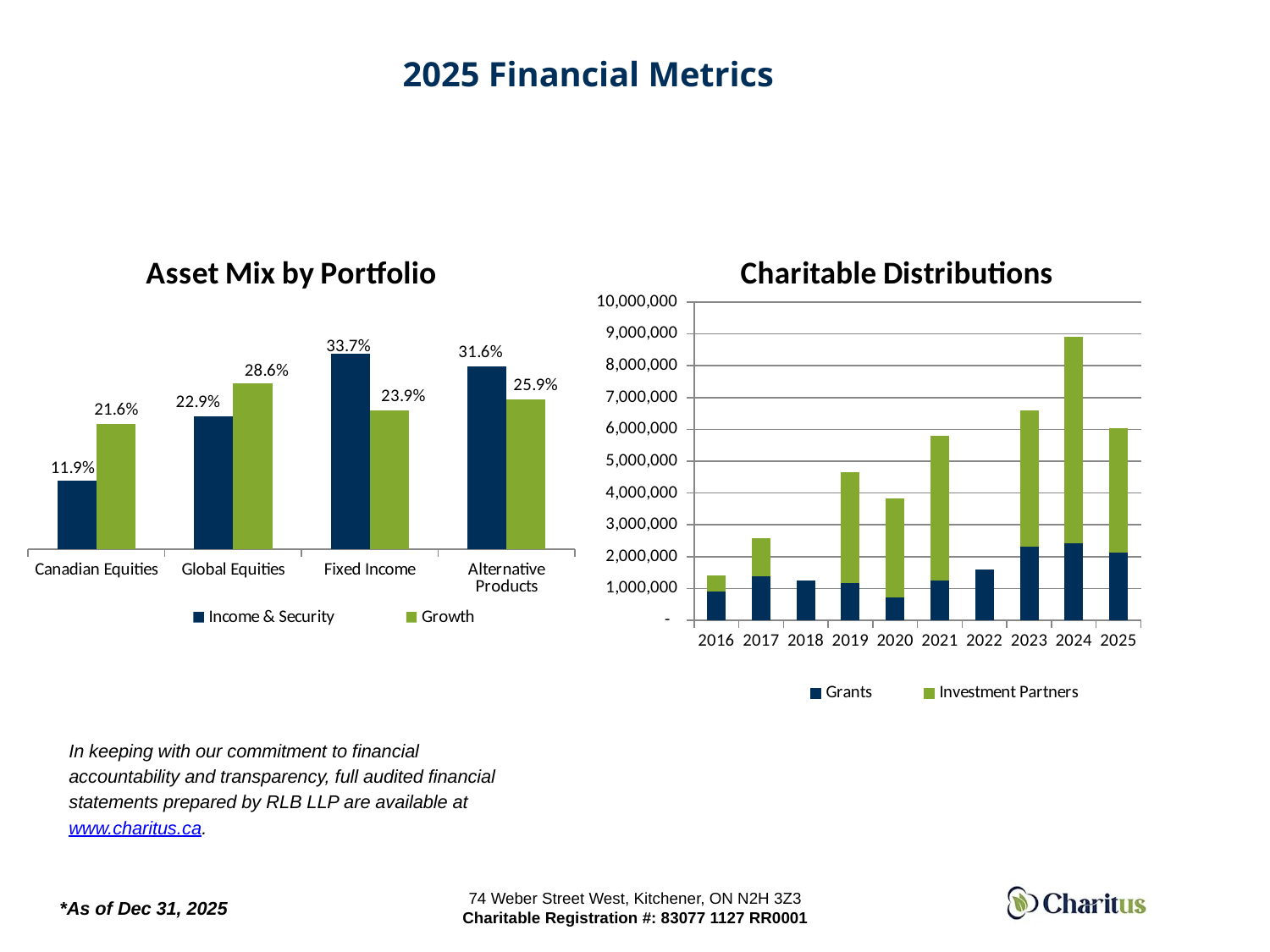
In the Asset Mix by Portfolio chart, what is the Growth value for Global Equities? 28.6% In the Charitable Distributions chart, which year has the highest total distribution? 2024 In the Asset Mix by Portfolio chart, what is the difference between the Growth and Income & Security values for Canadian Equities? 9.7% In the Asset Mix by Portfolio chart, which is larger for Alternative Products: Income & Security or Growth? Income & Security In the Charitable Distributions chart, is the total for 2022 greater or less than 2,000,000? less How many years are shown on the x axis of the Charitable Distributions chart? 10 In the Asset Mix by Portfolio chart, which category has the highest Growth value? Global Equities How many series does the legend of the Asset Mix by Portfolio chart list? 2 What type of chart is the Charitable Distributions chart? Stacked bar chart In the Asset Mix by Portfolio chart, what is the Income & Security value for Fixed Income? 33.7% In the Charitable Distributions chart, is the total for 2024 greater or less than 8,000,000? greater In the Asset Mix by Portfolio chart, which category has the lowest Income & Security value? Canadian Equities